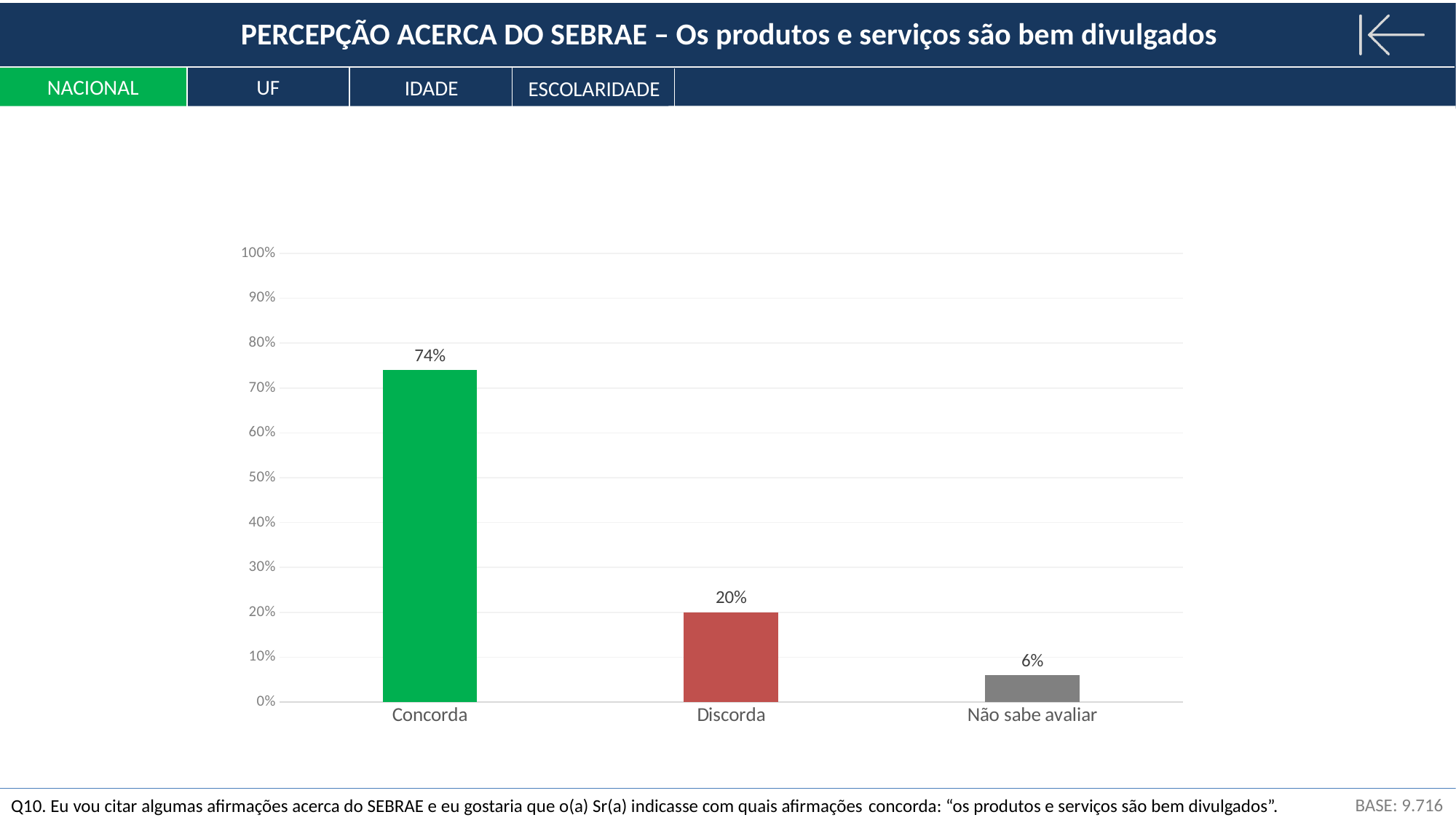
Is the value for Concorda greater or less than 70%? greater Which category has the lowest value? Não sabe avaliar Which category has the highest value? Concorda What is the value for Concorda? 74% What colour is the bar for Concorda? green What kind of chart is shown on the slide? bar chart How many categories are shown on the x axis? 3 What is the value for Não sabe avaliar? 6% What is the difference between the values for Discorda and Não sabe avaliar? 14% Which is larger, the value for Discorda or the value for Não sabe avaliar? Discorda What is the value for Discorda? 20% What is the difference between the values for Concorda and Discorda? 54%